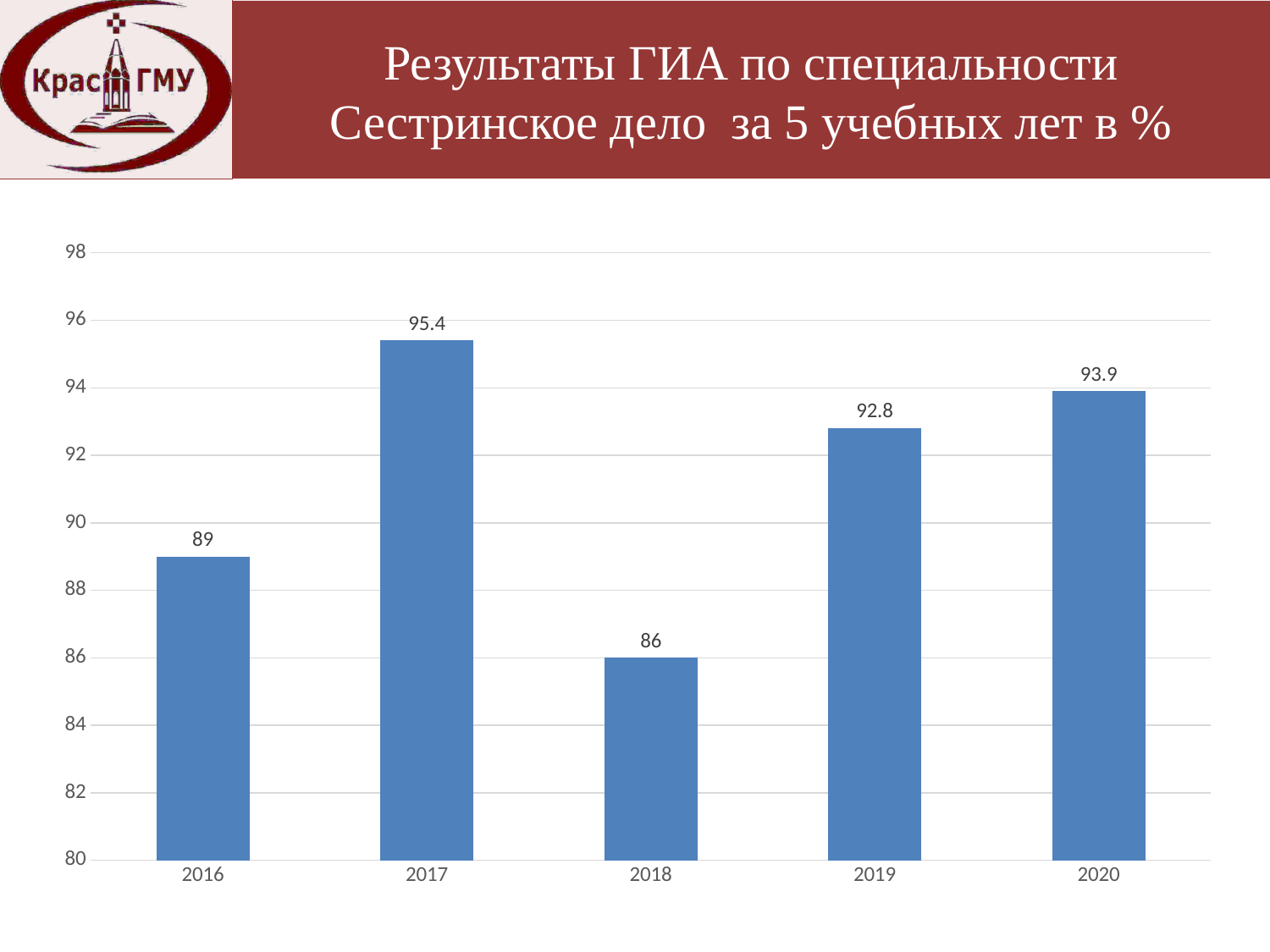
What is the value for 2018? 86 What kind of chart is shown on the slide? bar chart Does the value rise or fall from 2018 to 2019? rise Is the value for 2019 greater or less than 90? greater What is the value for 2020? 93.9 How many years are shown on the x axis? 5 Which year has the lowest value? 2018 What is the value for 2016? 89 Which is larger, the value for 2019 or the value for 2016? 2019 What is the difference between the values for 2017 and 2018? 9.4 What is the difference between the values for 2020 and 2019? 1.1 Which year has the highest value? 2017